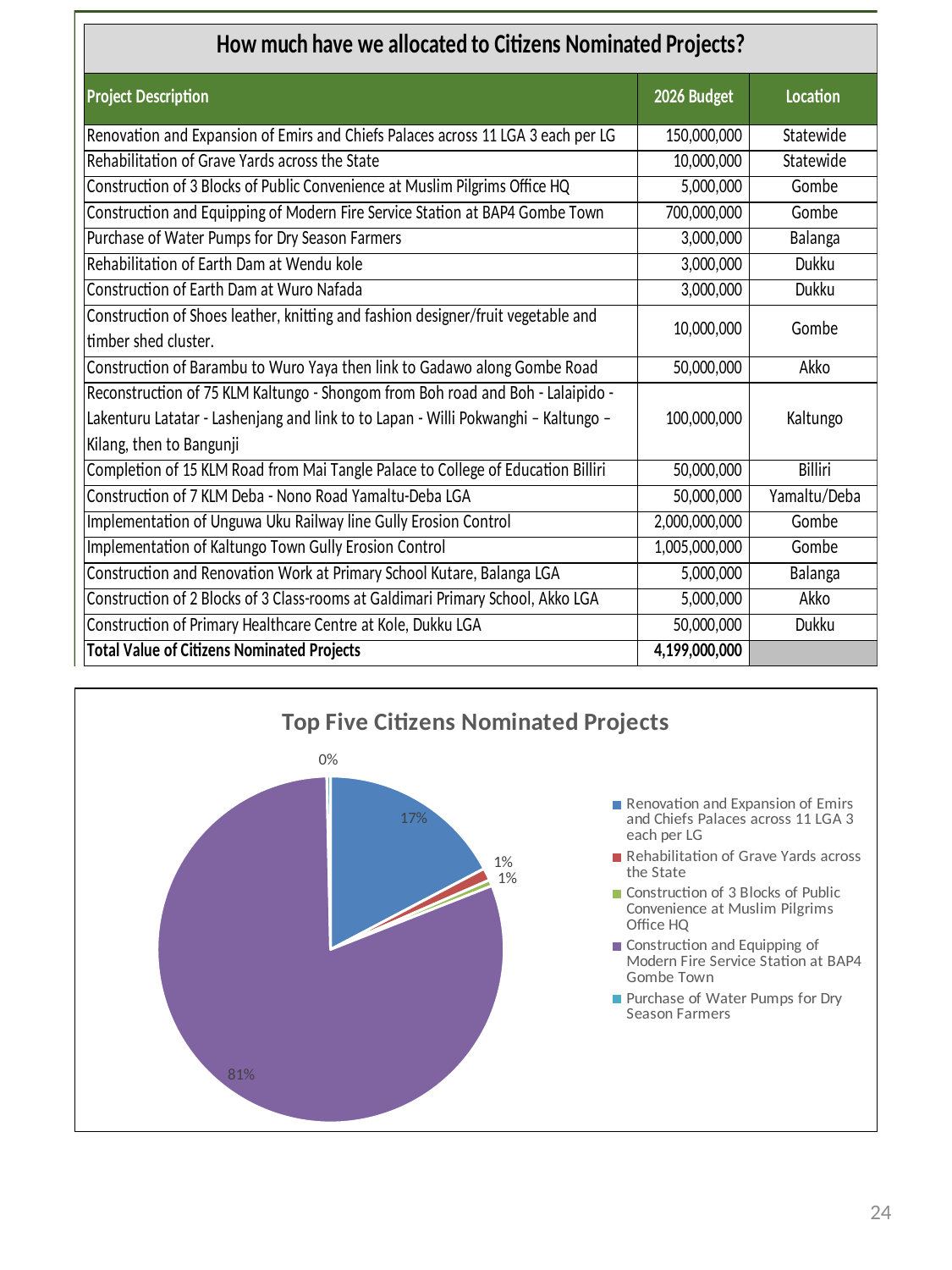
Which project has the smallest slice in the pie chart? Purchase of Water Pumps for Dry Season Farmers What kind of chart is shown under the title "Top Five Citizens Nominated Projects"? pie chart How many projects does the legend of the pie chart list? 5 In the pie chart, what share is shown for Construction and Equipping of Modern Fire Service Station at BAP4 Gombe Town? 81% In the pie chart, what share is shown for Purchase of Water Pumps for Dry Season Farmers? 0% What is the title of the pie chart on the slide? Top Five Citizens Nominated Projects In the pie chart, which slice is larger: Renovation and Expansion of Emirs and Chiefs Palaces or Rehabilitation of Grave Yards across the State? Renovation and Expansion of Emirs and Chiefs Palaces across 11 LGA 3 each per LG In the pie chart, what share is shown for Rehabilitation of Grave Yards across the State? 1% In the pie chart, what is the difference in percentage points between the Fire Service Station slice and the Emirs and Chiefs Palaces slice? 64 What colour is the largest slice in the pie chart? purple Which project has the largest slice in the pie chart? Construction and Equipping of Modern Fire Service Station at BAP4 Gombe Town